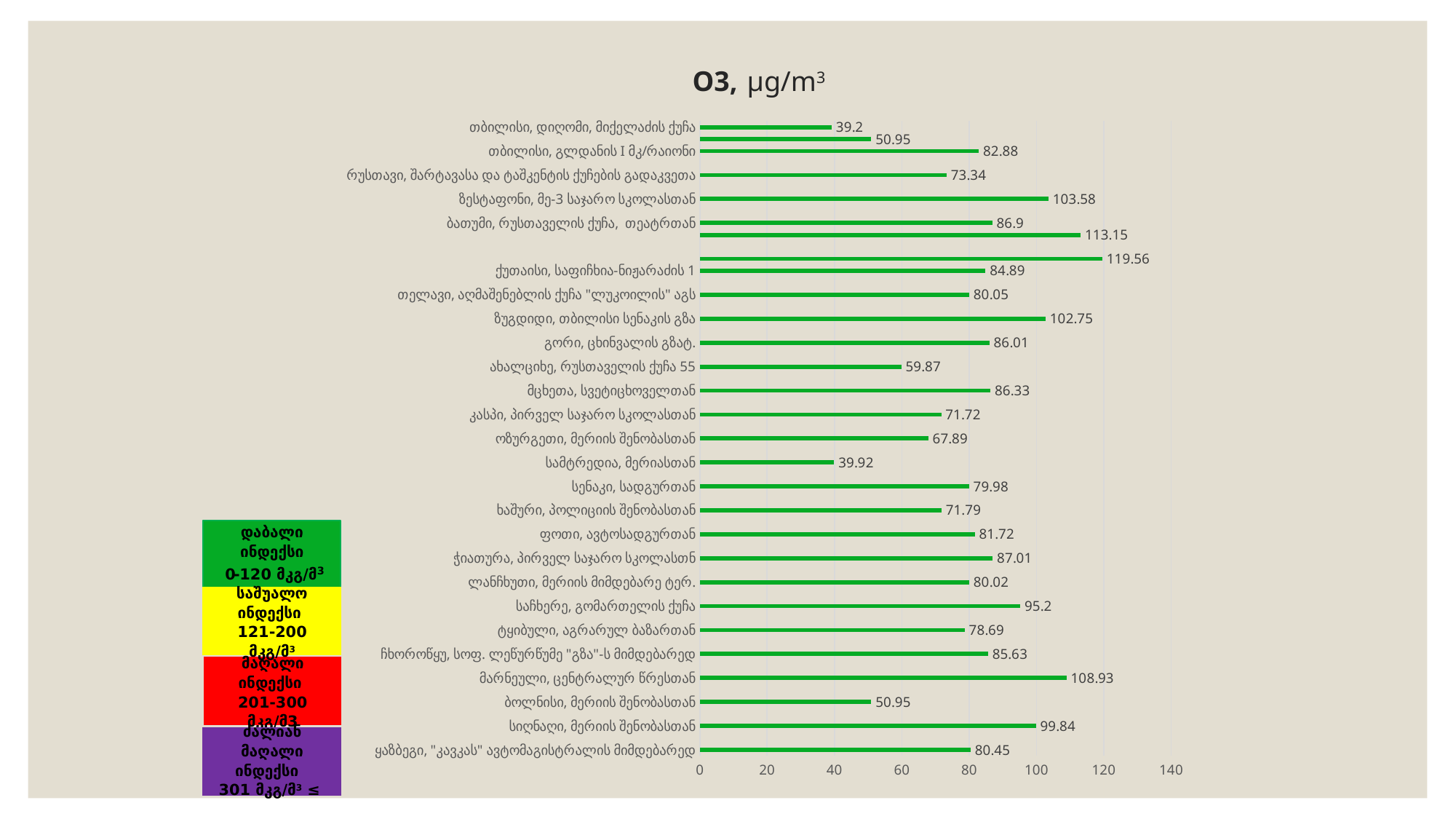
What type of chart is shown on the slide? bar chart What colour is used in the index legend for the low index range 0-120 მკგ/მ³? green What is the O3 value for ახალციხე, რუსთაველის ქუჩა 55? 59.87 What is the O3 value for სიღნაღი, მერიის შენობასთან? 99.84 What is the difference between the O3 values for მარნეული, ცენტრალურ წრესთან and ბოლნისი, მერიის შენობასთან? 57.98 What is the O3 value for ზესტაფონი, მე-3 საჯარო სკოლასთან? 103.58 Which has a higher O3 value: საჩხერე, გომართელის ქუჩა or სიღნაღი, მერიის შენობასთან? სიღნაღი, მერიის შენობასთან Which has a higher O3 value: ოზურგეთი, მერიის შენობასთან or ფოთი, ავტოსადგურთან? ფოთი, ავტოსადგურთან Is the O3 value for ზუგდიდი, თბილისი სენაკის გზა greater or less than 100? greater What is the title of the chart? O3, µg/m³ What is the O3 value for მარნეული, ცენტრალურ წრესთან? 108.93 What is the O3 value for სამტრედია, მერიასთან? 39.92